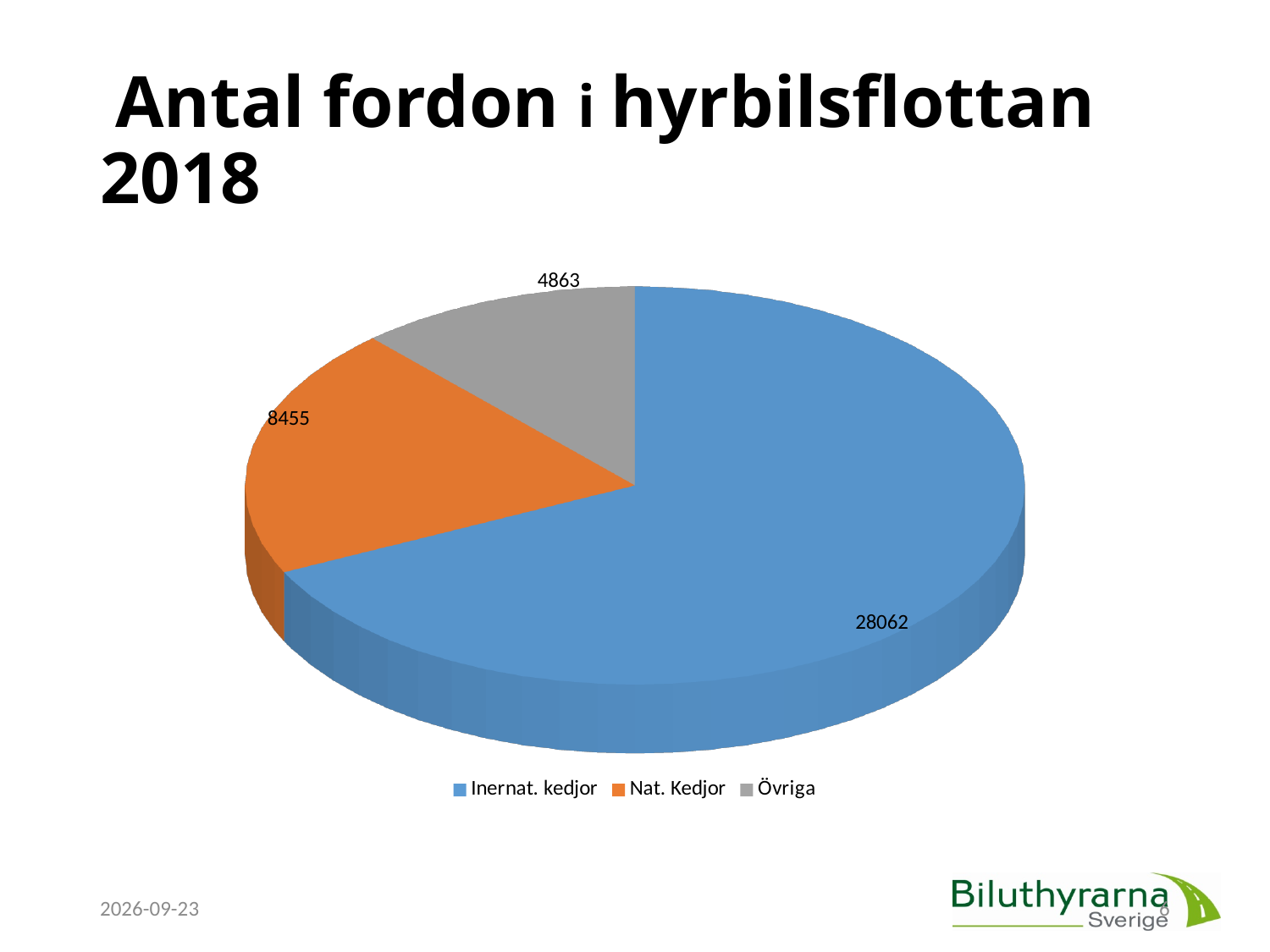
What is the value for Nat. Kedjor? 8455 What is the difference between the values for Inernat. kedjor and Nat. Kedjor? 19607 What is the title of the chart on the slide? Antal fordon i hyrbilsflottan 2018 Which category has the largest slice? Inernat. kedjor Which is larger, the value for Nat. Kedjor or the value for Övriga? Nat. Kedjor How many slices does the pie chart have? 3 What is the difference between the values for Nat. Kedjor and Övriga? 3592 What is the value for Inernat. kedjor? 28062 Which category has the smallest slice? Övriga What is the total of all slices in the pie chart? 41380 What kind of chart is shown on the slide? pie chart What is the value for Övriga? 4863